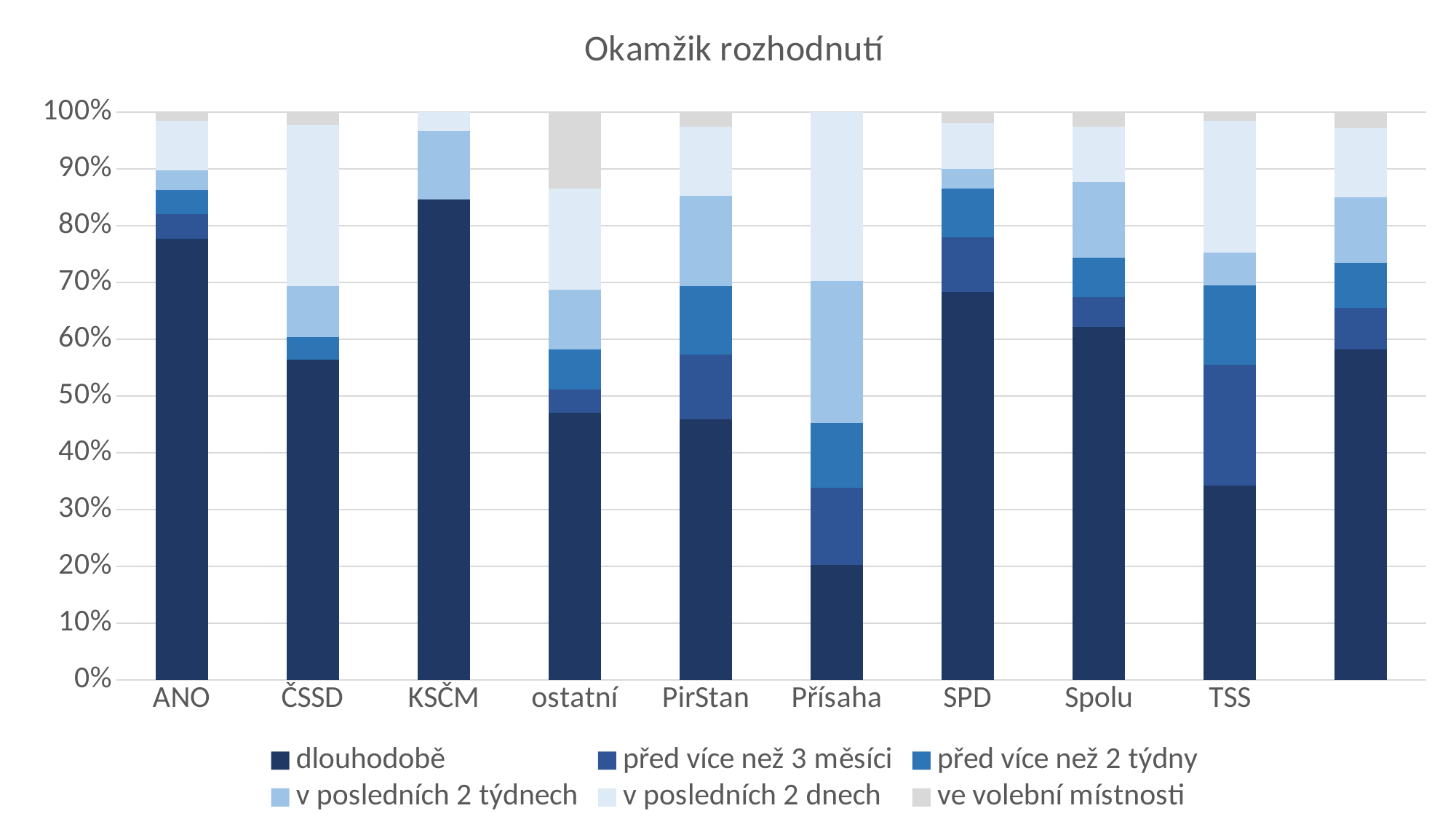
Is the 'dlouhodobě' value for TSS greater or less than 40%? less What is the title of the chart? Okamžik rozhodnutí Which has the larger 'dlouhodobě' segment, SPD or Spolu? SPD Which category has the largest 'před více než 3 měsíci' segment? TSS Which category has the largest 'v posledních 2 týdnech' segment? Přísaha Is the 'dlouhodobě' value for ANO greater or less than 70%? greater Which category has the largest 've volební místnosti' segment? ostatní Which category has the smallest 'dlouhodobě' segment? Přísaha Is the 'dlouhodobě' value for Přísaha greater or less than 30%? less How many series does the legend list? 6 What kind of chart is shown on the slide? stacked bar chart